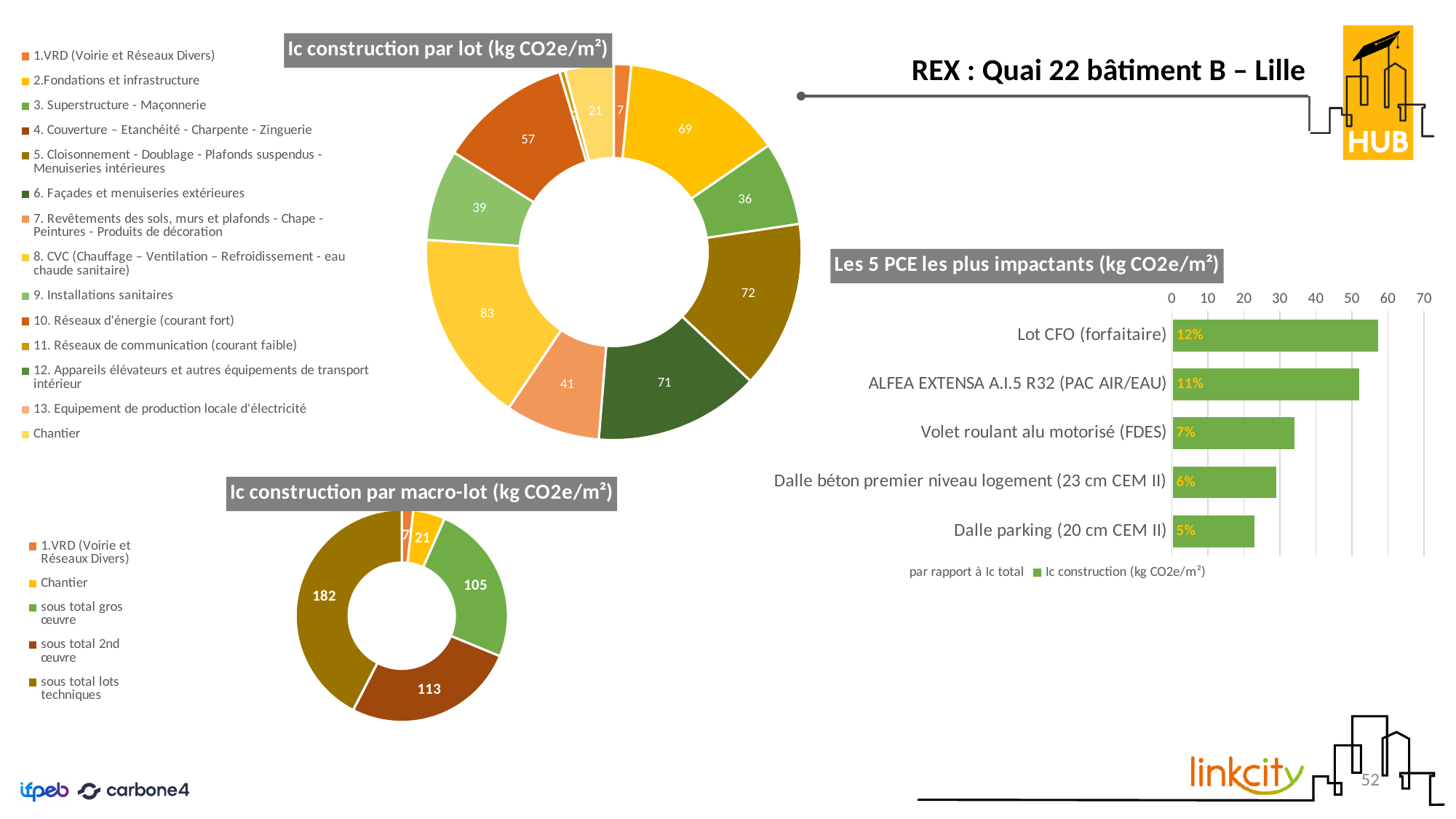
In the 'Ic construction par macro-lot' chart, what is the value for 'sous total lots techniques'? 182 How many categories does the 'Ic construction par macro-lot' chart show? 5 In the 'Les 5 PCE les plus impactants' chart, is the value for 'Lot CFO (forfaitaire)' greater or less than 50? greater In the 'Ic construction par macro-lot' chart, what is the total of all the slices? 428 In the 'Les 5 PCE les plus impactants' chart, what percentage label is shown for 'Volet roulant alu motorisé (FDES)'? 7% In the 'Les 5 PCE les plus impactants' chart, is the value for 'Dalle parking (20 cm CEM II)' greater or less than 30? less What kind of chart is 'Les 5 PCE les plus impactants'? bar chart In the 'Ic construction par macro-lot' chart, what is the difference between 'sous total lots techniques' and 'sous total 2nd œuvre'? 69 In the 'Ic construction par macro-lot' chart, which category has the smallest value? 1.VRD (Voirie et Réseaux Divers) In the 'Ic construction par lot' chart, what is the value for 'Chantier'? 21 In the 'Ic construction par lot' chart, what is the largest value shown on any slice? 83 In the 'Ic construction par macro-lot' chart, which category has the largest value? sous total lots techniques